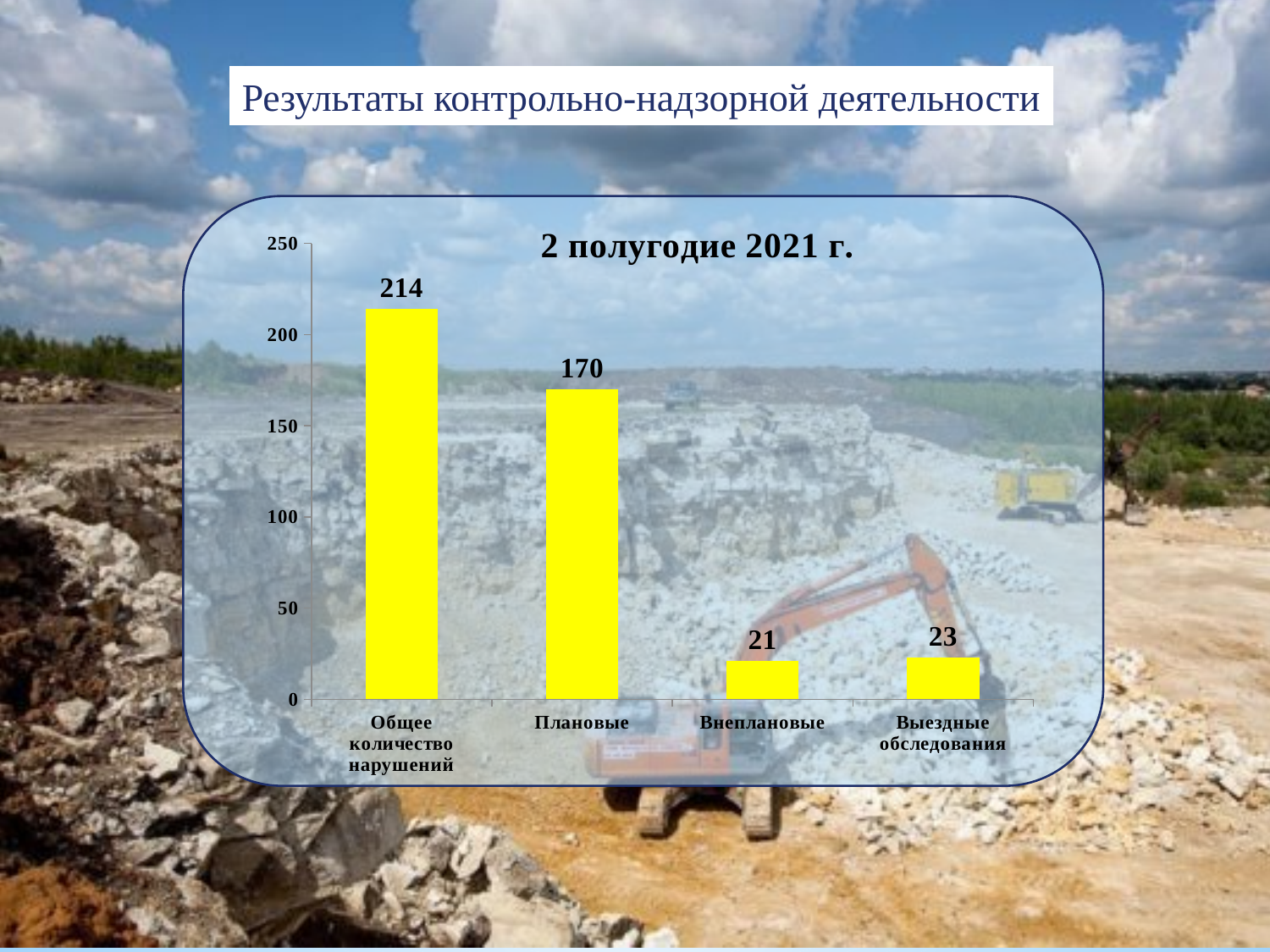
What kind of chart is shown on the slide? bar chart What is the difference between Выездные обследования and Внеплановые? 2 Which is larger, Плановые or Внеплановые? Плановые Is the value for Плановые greater or less than 150? greater Which category has the highest value? Общее количество нарушений What is the value for Общее количество нарушений? 214 How many categories are shown on the chart? 4 What is the value for Внеплановые? 21 What is the difference between Общее количество нарушений and Плановые? 44 What is the value for Выездные обследования? 23 What is the value for Плановые? 170 Which category has the lowest value? Внеплановые